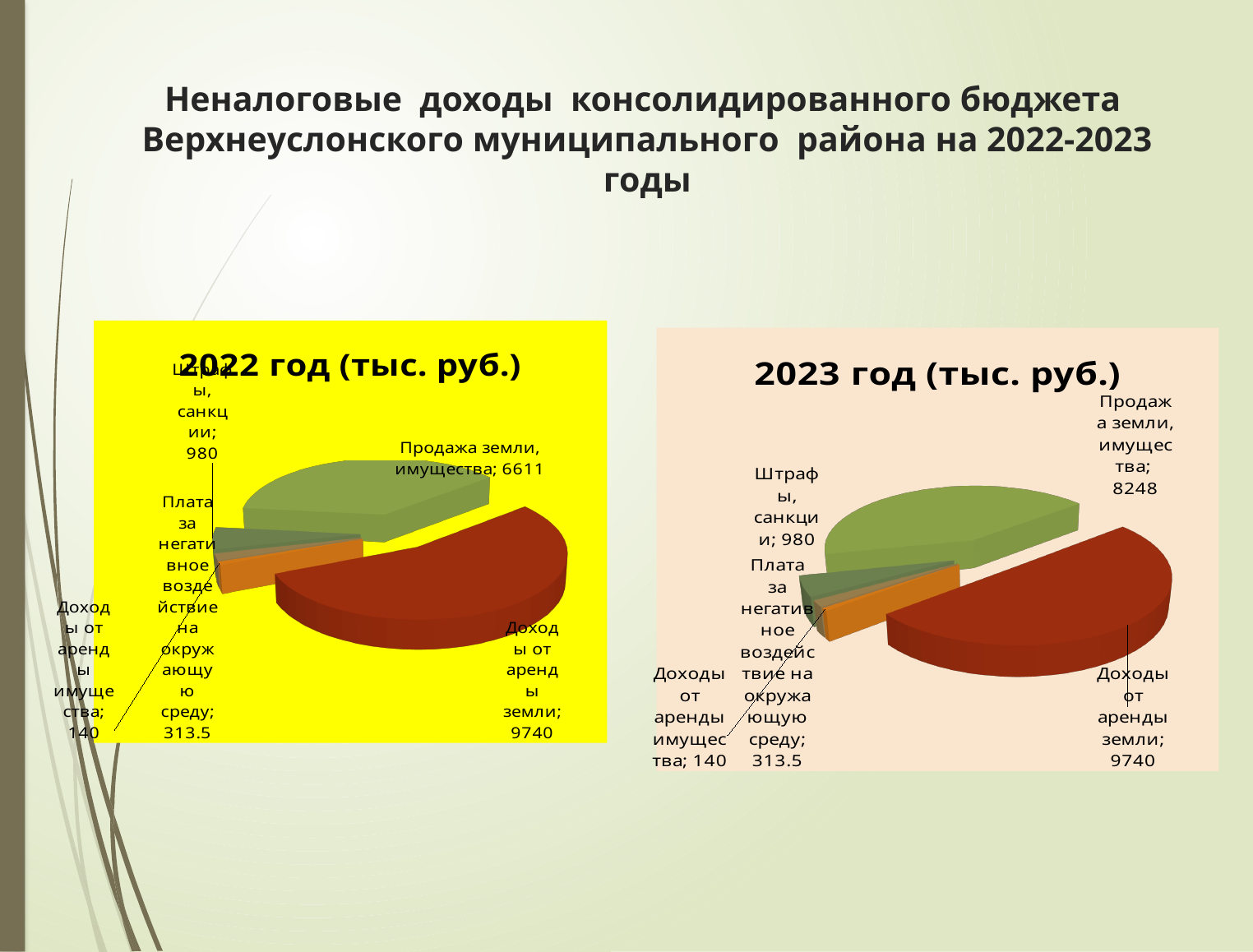
In the 2023 год (тыс. руб.) chart, which category has the smallest value? Доходы от аренды имущества In the 2022 год (тыс. руб.) chart, what is the value for Доходы от аренды земли? 9740 In the 2022 год (тыс. руб.) chart, what is the difference between Доходы от аренды земли and Продажа земли, имущества? 3129 What is the difference between Продажа земли, имущества in the 2023 chart and in the 2022 chart? 1637 In the 2023 год (тыс. руб.) chart, what is the value for Штрафы, санкции? 980 In the 2022 год (тыс. руб.) chart, what is the value for Плата за негативное воздействие на окружающую среду? 313.5 How many categories are shown in the 2022 год (тыс. руб.) chart? 5 What is the title of the chart on the left side of the slide? 2022 год (тыс. руб.) In the 2023 год (тыс. руб.) chart, which is larger: Штрафы, санкции or Плата за негативное воздействие на окружающую среду? Штрафы, санкции What type of chart is the 2023 год (тыс. руб.) chart? Pie chart In the 2023 год (тыс. руб.) chart, what is the value for Продажа земли, имущества? 8248 In the 2022 год (тыс. руб.) chart, which category has the largest value? Доходы от аренды земли